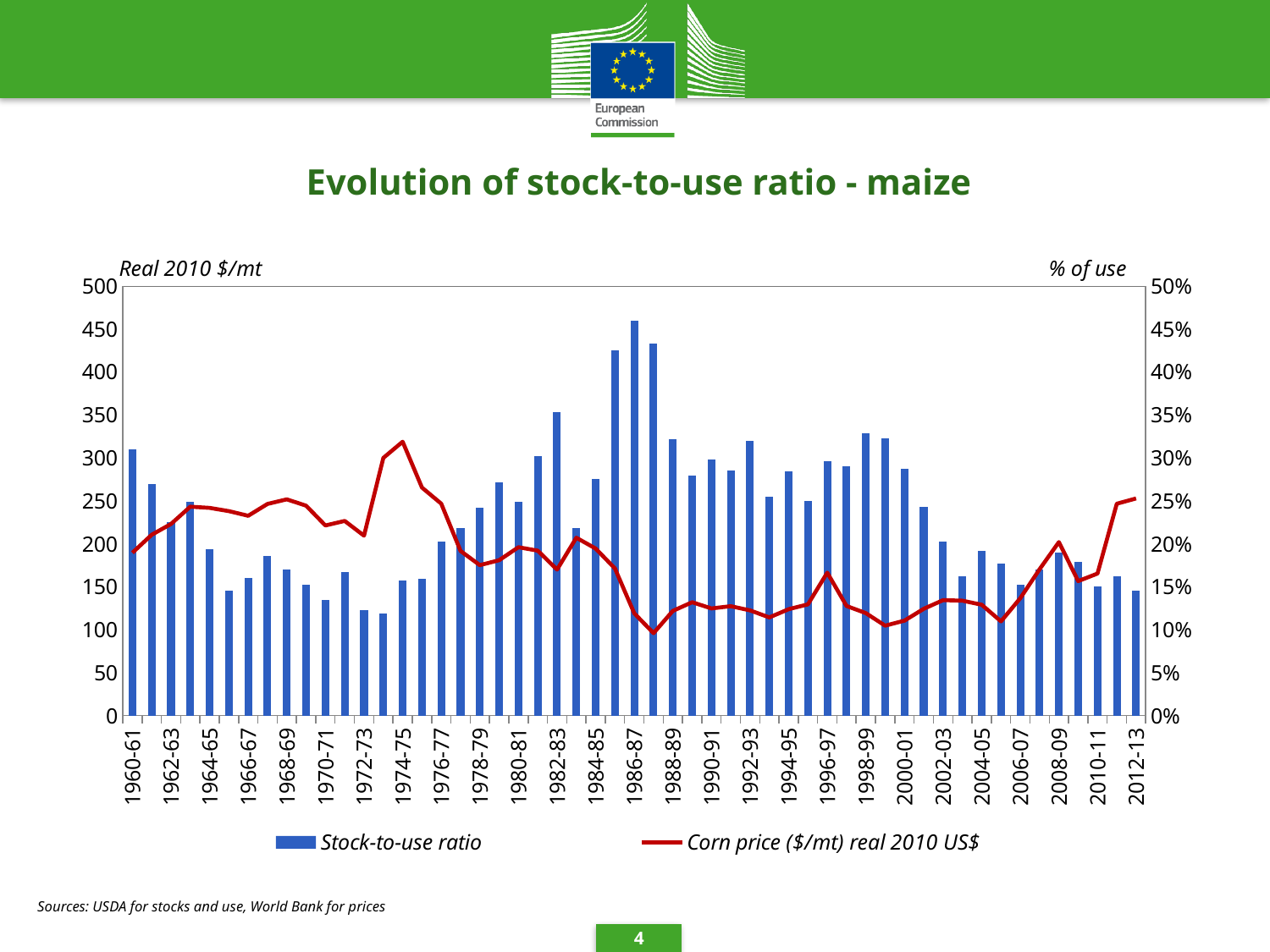
Does the corn price line rise or fall from 1974-75 to 1987-88? fall What is the title of the chart? Evolution of stock-to-use ratio - maize What kind of chart is shown on the slide? A combined bar and line chart Is the corn price for 1974-75 greater or less than 300 $/mt? greater How many series does the legend list? 2 Is the stock-to-use ratio for 1986-87 greater or less than 40%? greater Does the stock-to-use ratio rise or fall from 1998-99 to 2006-07? fall Is the stock-to-use ratio for 1960-61 greater or less than 25%? greater What label is shown above the left vertical axis? Real 2010 $/mt In which year is the stock-to-use ratio bar the highest? 1986-87 Which year has the higher stock-to-use ratio, 1986-87 or 1960-61? 1986-87